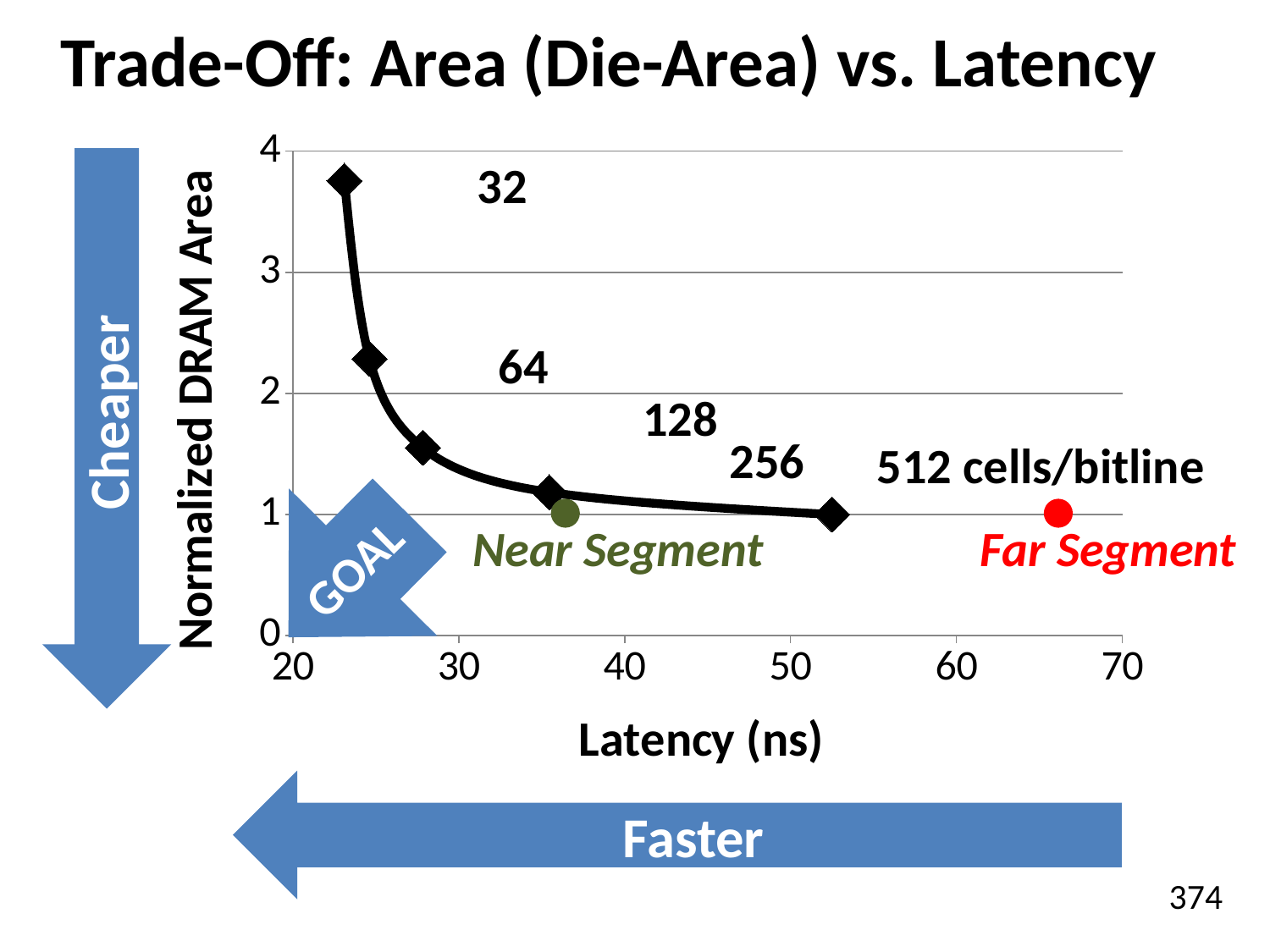
Which cells/bitline configuration has the lowest normalized DRAM area? 512 As latency increases along the x axis, does the normalized DRAM area rise or fall? fall Is the latency of the Near Segment point greater or less than 40 ns? less Is the normalized DRAM area for 32 cells/bitline greater or less than 3? greater Which cells/bitline configuration has the highest normalized DRAM area? 32 How many cells/bitline data points are plotted on the black curve? 5 Which has a larger normalized DRAM area, 32 cells/bitline or 64 cells/bitline? 32 cells/bitline Is the latency of the Far Segment point greater or less than 60 ns? greater What is the label of the x axis? Latency (ns) What kind of chart is shown on the slide? line chart What is the normalized DRAM area for 512 cells/bitline? 1